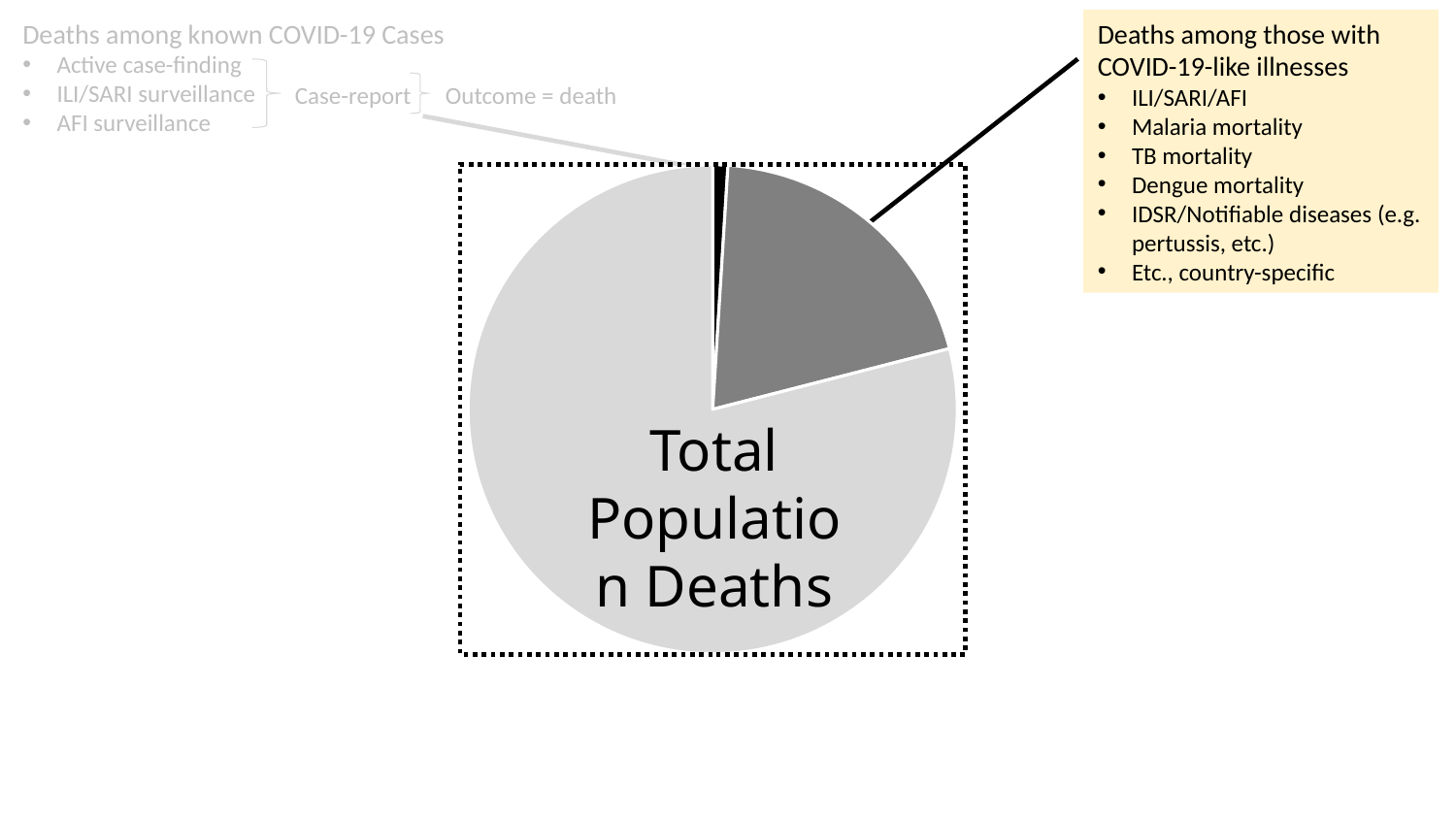
Which is larger in the pie chart: the Total Population Deaths slice or the slice for deaths among those with COVID-19-like illnesses? Total Population Deaths Which slice of the pie chart is the smallest? Deaths among known COVID-19 Cases How many slices does the pie chart have? 3 Is the Total Population Deaths slice more or less than half of the pie? more What colour is the slice representing deaths among those with COVID-19-like illnesses? dark gray Which is larger in the pie chart: the slice for deaths among those with COVID-19-like illnesses or the slice for deaths among known COVID-19 cases? Deaths among those with COVID-19-like illnesses What text label is printed inside the largest slice of the pie chart? Total Population Deaths Which slice of the pie chart is the largest? Total Population Deaths What kind of chart is shown on the slide? pie chart